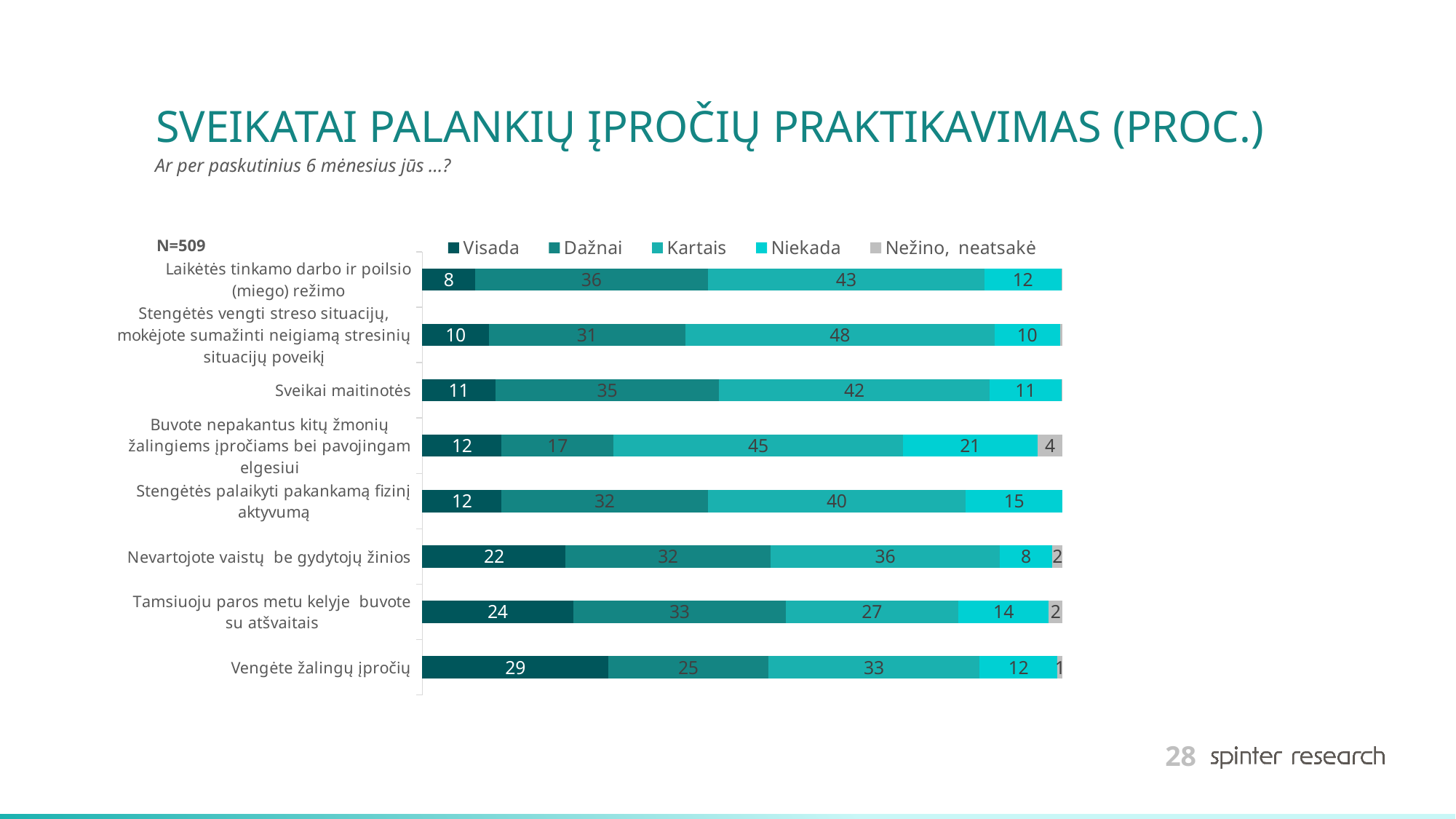
How many series does the legend list? 5 What sample size (N) is shown on the chart? N=509 What is the 'Visada' value for 'Vengėte žalingų įpročių'? 29 Which category has the lowest 'Visada' value? Laikėtės tinkamo darbo ir poilsio (miego) režimo Which category has the highest 'Visada' value? Vengėte žalingų įpročių Which is larger: the 'Dažnai' value for 'Sveikai maitinotės' or the 'Dažnai' value for 'Buvote nepakantus kitų žmonių žalingiems įpročiams bei pavojingam elgesiui'? Sveikai maitinotės What is the total of the stacked bar for 'Tamsiuoju paros metu kelyje buvote su atšvaitais'? 100 What is the difference between the 'Visada' values for 'Tamsiuoju paros metu kelyje buvote su atšvaitais' and 'Nevartojote vaistų be gydytojų žinios'? 2 What is the 'Kartais' value for 'Stengėtės vengti streso situacijų, mokėjote sumažinti neigiamą stresinių situacijų poveikį'? 48 What kind of chart is shown on the slide? Stacked bar chart How many categories (statements) are plotted in the chart? 8 What is the 'Niekada' value for 'Buvote nepakantus kitų žmonių žalingiems įpročiams bei pavojingam elgesiui'? 21